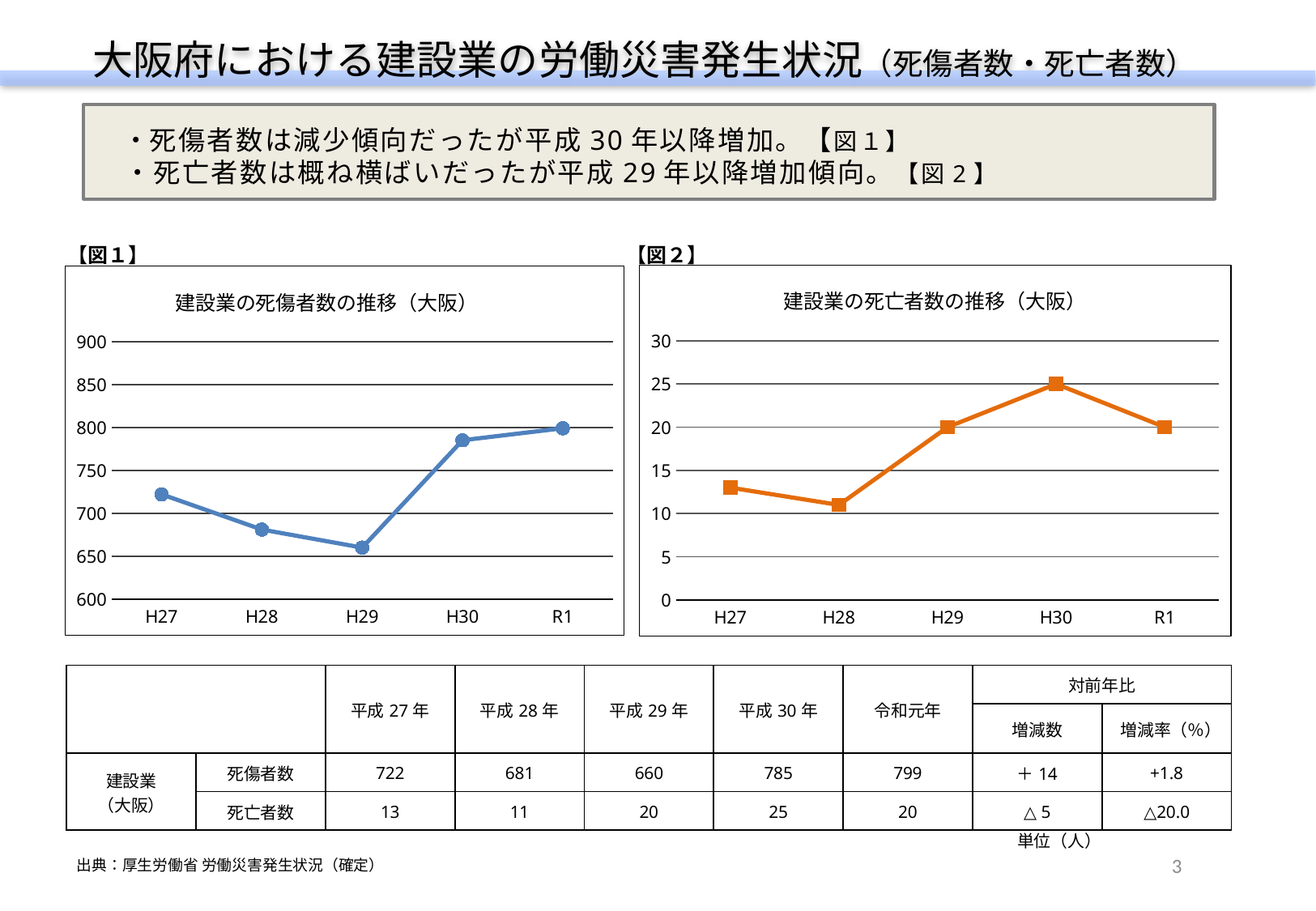
In the chart titled 建設業の死亡者数の推移（大阪）, which year has the lowest value? H28 What kind of chart is the chart titled 建設業の死傷者数の推移（大阪）? line chart In the chart titled 建設業の死傷者数の推移（大阪）, which year has the highest value? R1 How many data points are plotted in the chart titled 建設業の死亡者数の推移（大阪）? 5 In the chart titled 建設業の死亡者数の推移（大阪）, which is larger, the value for H27 or the value for H29? H29 In the chart titled 建設業の死傷者数の推移（大阪）, do the values rise or fall from H27 to H29? fall In the chart titled 建設業の死傷者数の推移（大阪）, what is the difference between the values for R1 and H30? 14 In the chart titled 建設業の死傷者数の推移（大阪）, is the value for H29 greater or less than 700? less In the chart titled 建設業の死亡者数の推移（大阪）, what is the difference between the values for H30 and R1? 5 In the chart titled 建設業の死傷者数の推移（大阪）, which year has the lowest value? H29 In the chart titled 建設業の死傷者数の推移（大阪）, what is the value for H27? 722 In the chart titled 建設業の死亡者数の推移（大阪）, what is the value for H30? 25